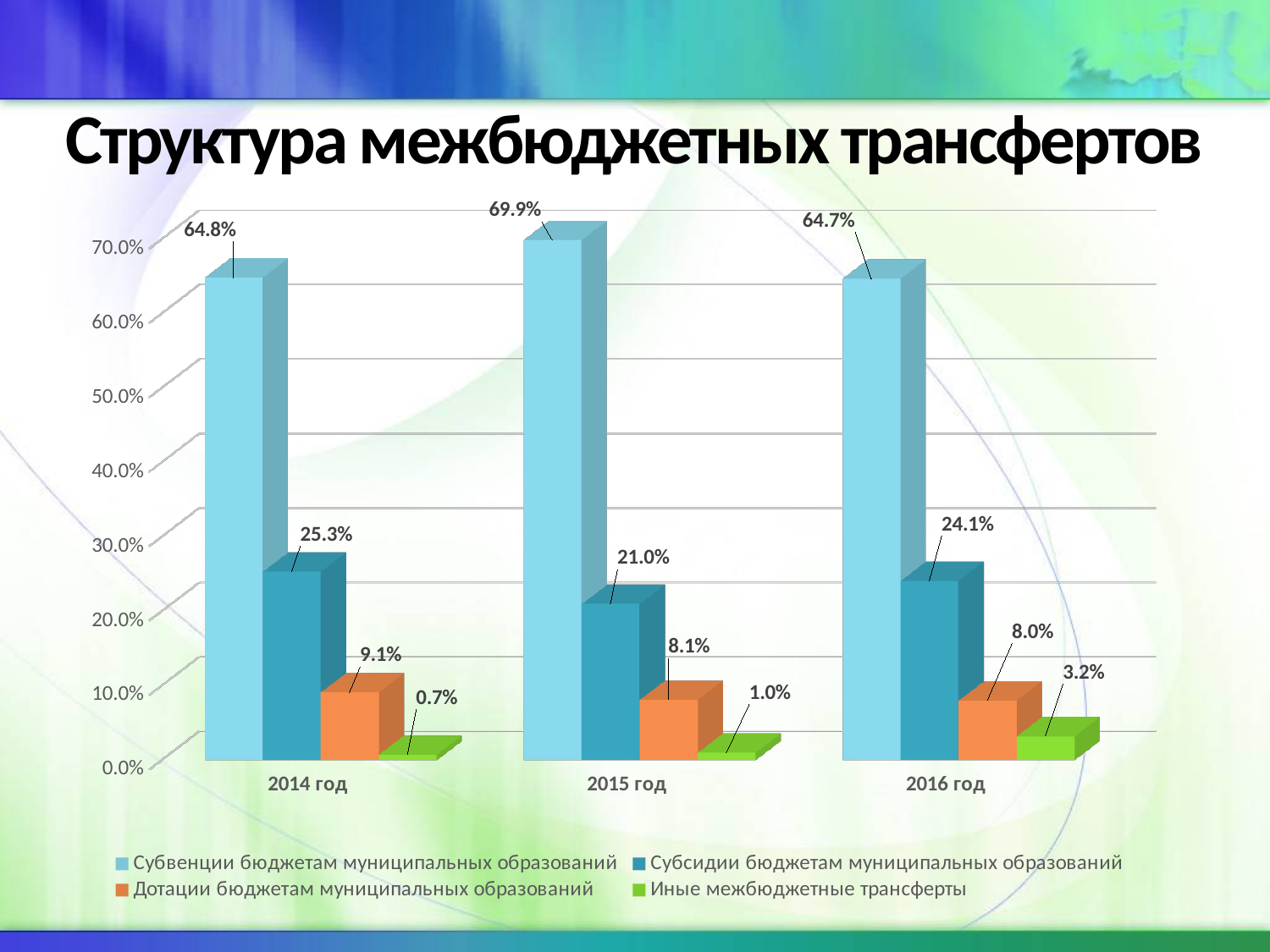
In which year is the value for Иные межбюджетные трансферты lowest? 2014 год Which is larger: Дотации бюджетам муниципальных образований in 2014 год or in 2015 год? 2014 год What is the difference between the Субсидии бюджетам муниципальных образований values for 2014 год and 2015 год? 4.3% What is the title of the chart? Структура межбюджетных трансфертов What is the value for Дотации бюджетам муниципальных образований in 2016 год? 8.0% What is the value for Субвенции бюджетам муниципальных образований in 2015 год? 69.9% How many series does the legend list? 4 What kind of chart is shown on the slide? Bar chart In which year is the value for Субвенции бюджетам муниципальных образований highest? 2015 год How many years are shown on the x axis? 3 What is the value for Субсидии бюджетам муниципальных образований in 2014 год? 25.3% What is the value for Иные межбюджетные трансферты in 2016 год? 3.2%